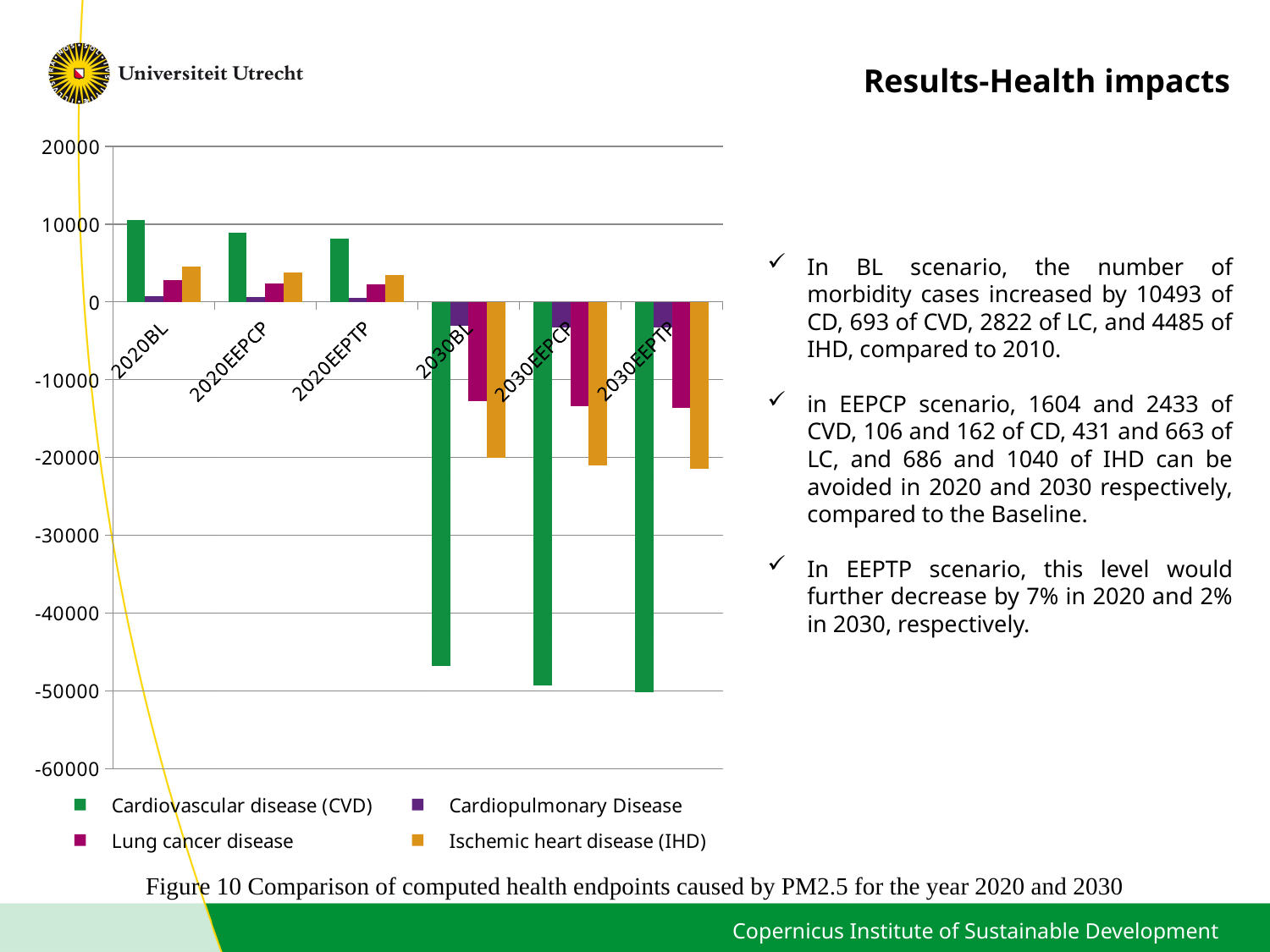
How many categories are shown on the x axis of the chart? 6 Is the Lung cancer disease value for 2030BL greater or less than -10000? less Which is larger, the Cardiovascular disease (CVD) value for 2020BL or for 2020EEPCP? 2020BL What kind of chart is shown on the slide? bar chart Which is larger in the 2020BL category, Ischemic heart disease (IHD) or Lung cancer disease? Ischemic heart disease (IHD) Is the Cardiovascular disease (CVD) value for 2020EEPCP greater or less than 10000? less Which series has the highest value in the 2020BL category? Cardiovascular disease (CVD) Are the values for the 2030 categories positive or negative? negative What colour represents Ischemic heart disease (IHD) in the chart's legend? orange Which series has the lowest value in the 2030BL category? Cardiovascular disease (CVD) Is the Cardiovascular disease (CVD) value for 2030BL greater or less than -40000? less How many series does the chart's legend list? 4